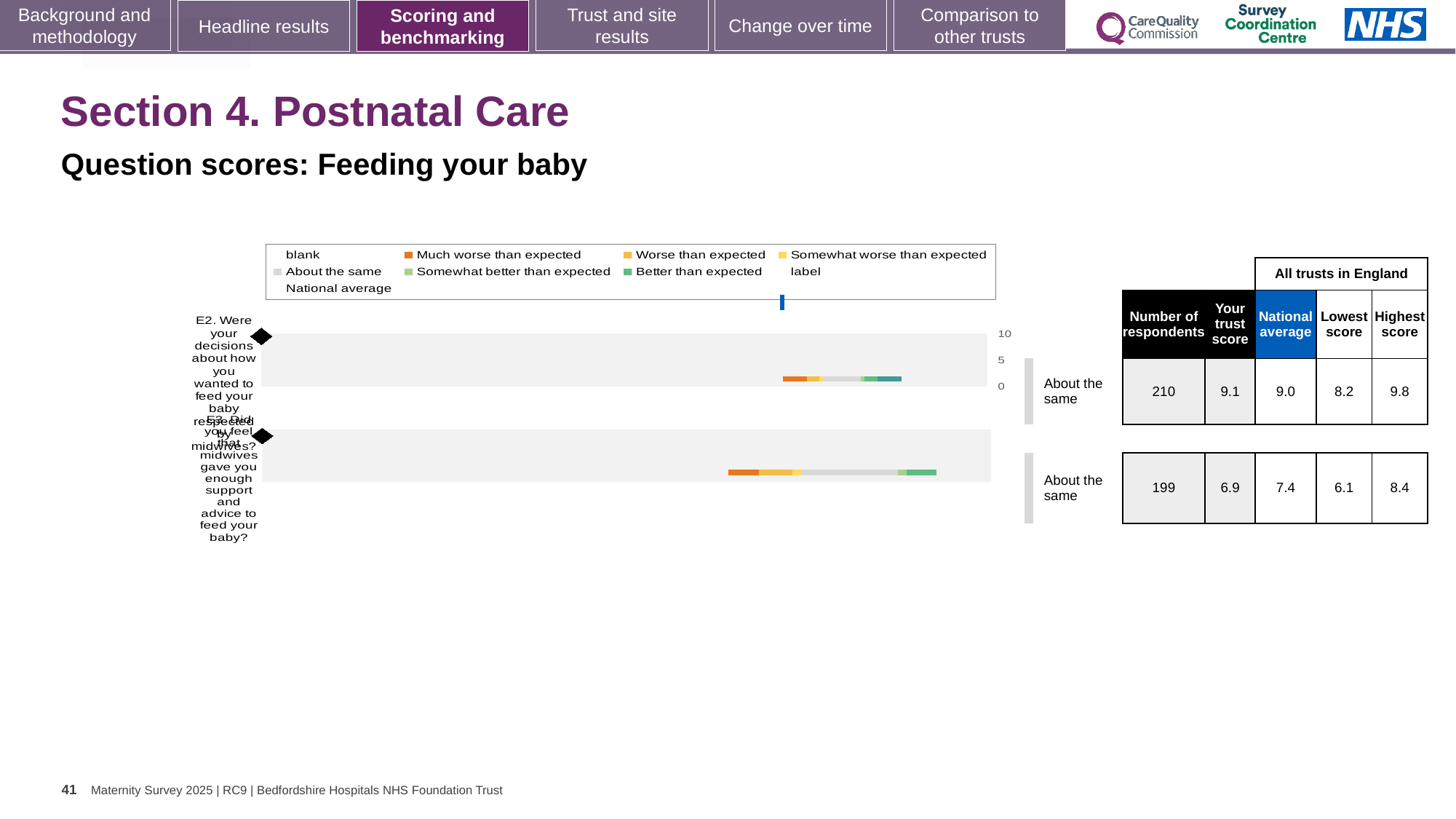
Which question has the higher 'Highest score' across all trusts in England? E2 What is the difference between the Highest score and the Lowest score for question E3? 2.3 What is the National average shown for question E3 (midwives gave you enough support and advice to feed your baby)? 7.4 What colour does the legend use for 'Much worse than expected'? Orange How many survey questions are plotted as bars in the chart? 2 What is the Lowest score shown for question E2? 8.2 How many respondents are shown for question E2? 210 What is the difference between the trust score and the National average for question E2? 0.1 Which question has the higher 'Your trust score', E2 or E3? E2 What is the 'Your trust score' shown for question E2 (decisions about how you wanted to feed your baby respected by midwives)? 9.1 What benchmark category label is shown next to both bars in the chart? About the same What kind of chart is shown on the slide? Bar chart